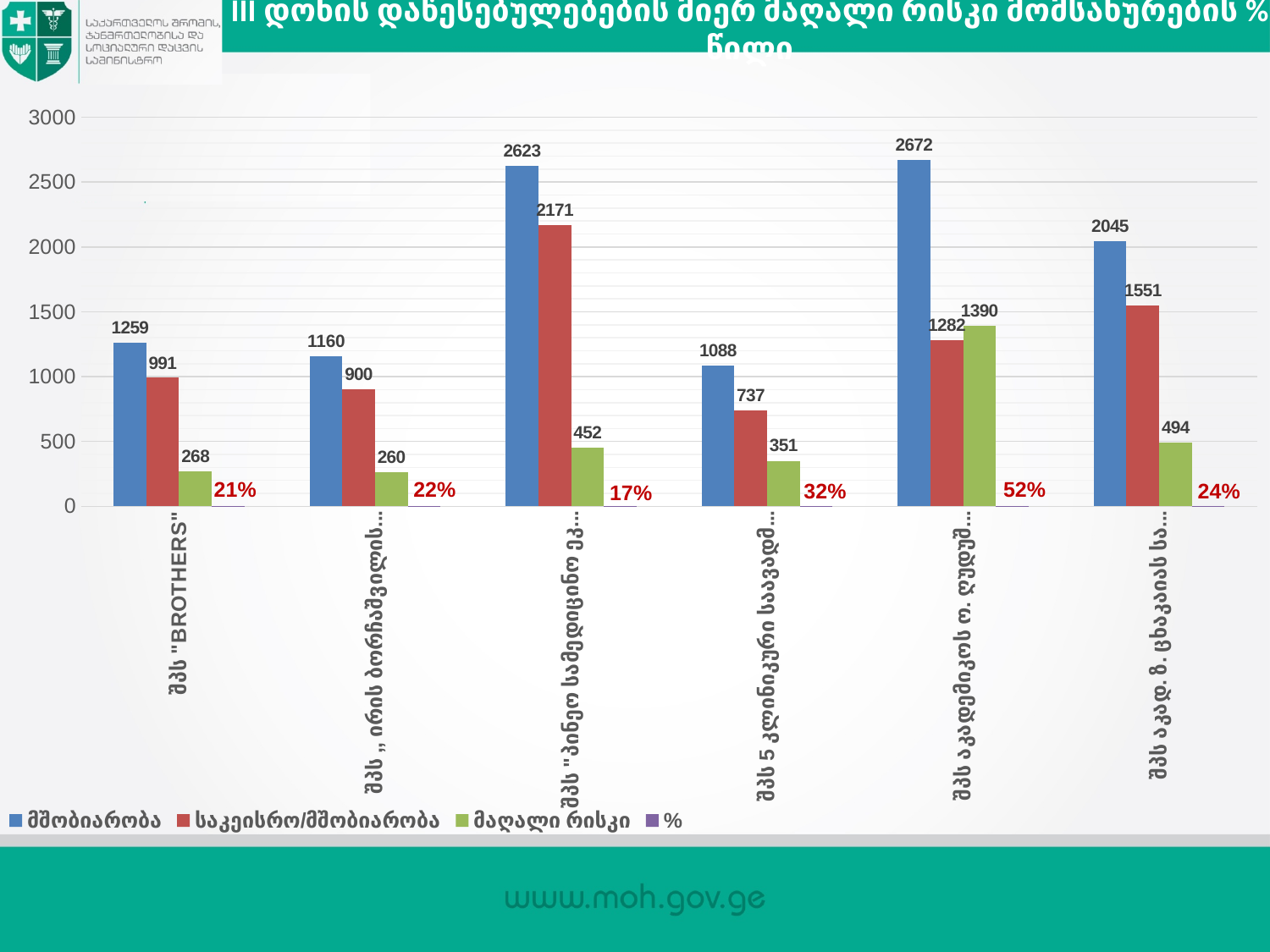
How many series does the legend list? 4 What percentage is shown for შპს აკადემიკოს ო. ღუდუშ...? 52% What is the მაღალი რისკი value for შპს 5 კლინიკური საავადმ...? 351 What is the difference between the მშობიარობა and საკეისრო/მშობიარობა values for შპს "პინეო სამედიცინო ექ...? 452 Which category has the lowest მაღალი რისკი value? შპს „ირის ბორჩაშვილის... How many categories are shown on the x axis? 6 Is the მშობიარობა value for შპს 5 კლინიკური საავადმ... greater or less than 1000? greater What is the საკეისრო/მშობიარობა value for შპს "BROTHERS"? 991 What is the მშობიარობა value for შპს "BROTHERS"? 1259 Which is larger: the მაღალი რისკი value for შპს აკადემიკოს ო. ღუდუშ... or for შპს აკად. ზ. ცხაკაიას სა...? შპს აკადემიკოს ო. ღუდუშ... Which category has the highest მშობიარობა value? შპს აკადემიკოს ო. ღუდუშ... What kind of chart is shown on the slide? bar chart